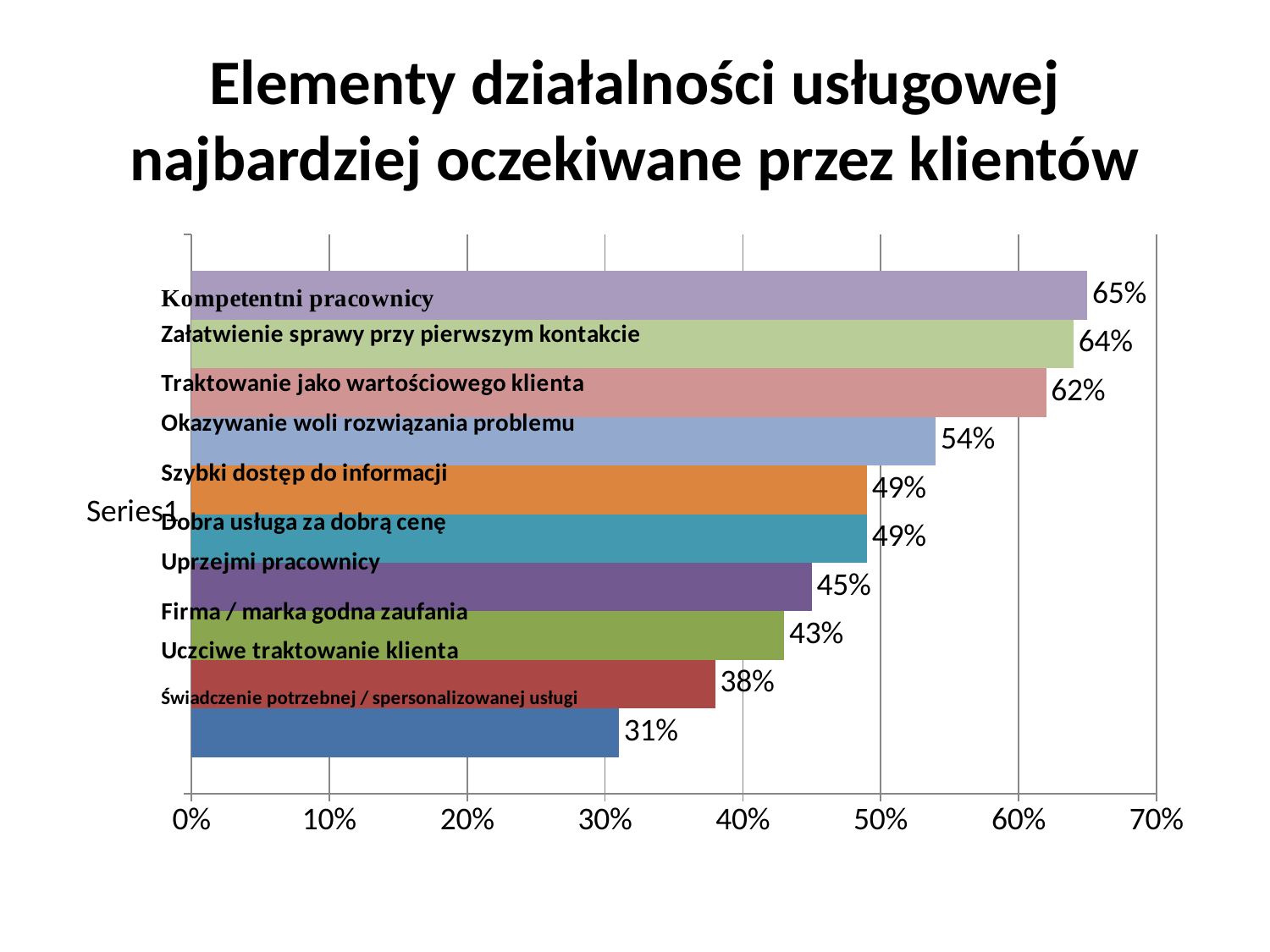
What is the value for Kompetentni pracownicy? 65% What is the title of the slide? Elementy działalności usługowej najbardziej oczekiwane przez klientów Which is larger, the value for Traktowanie jako wartościowego klienta or the value for Firma / marka godna zaufania? Traktowanie jako wartościowego klienta What is the difference between the values for Kompetentni pracownicy and Uczciwe traktowanie klienta? 27% What is the value for Okazywanie woli rozwiązania problemu? 54% Which category has the highest value? Kompetentni pracownicy What is the value for Świadczenie potrzebnej / spersonalizowanej usługi? 31% How many categories are shown in the chart? 10 Which category has the lowest value? Świadczenie potrzebnej / spersonalizowanej usługi What type of chart is shown on the slide? bar chart What is the highest value shown on the x axis? 70% What is the value for Uprzejmi pracownicy? 45%